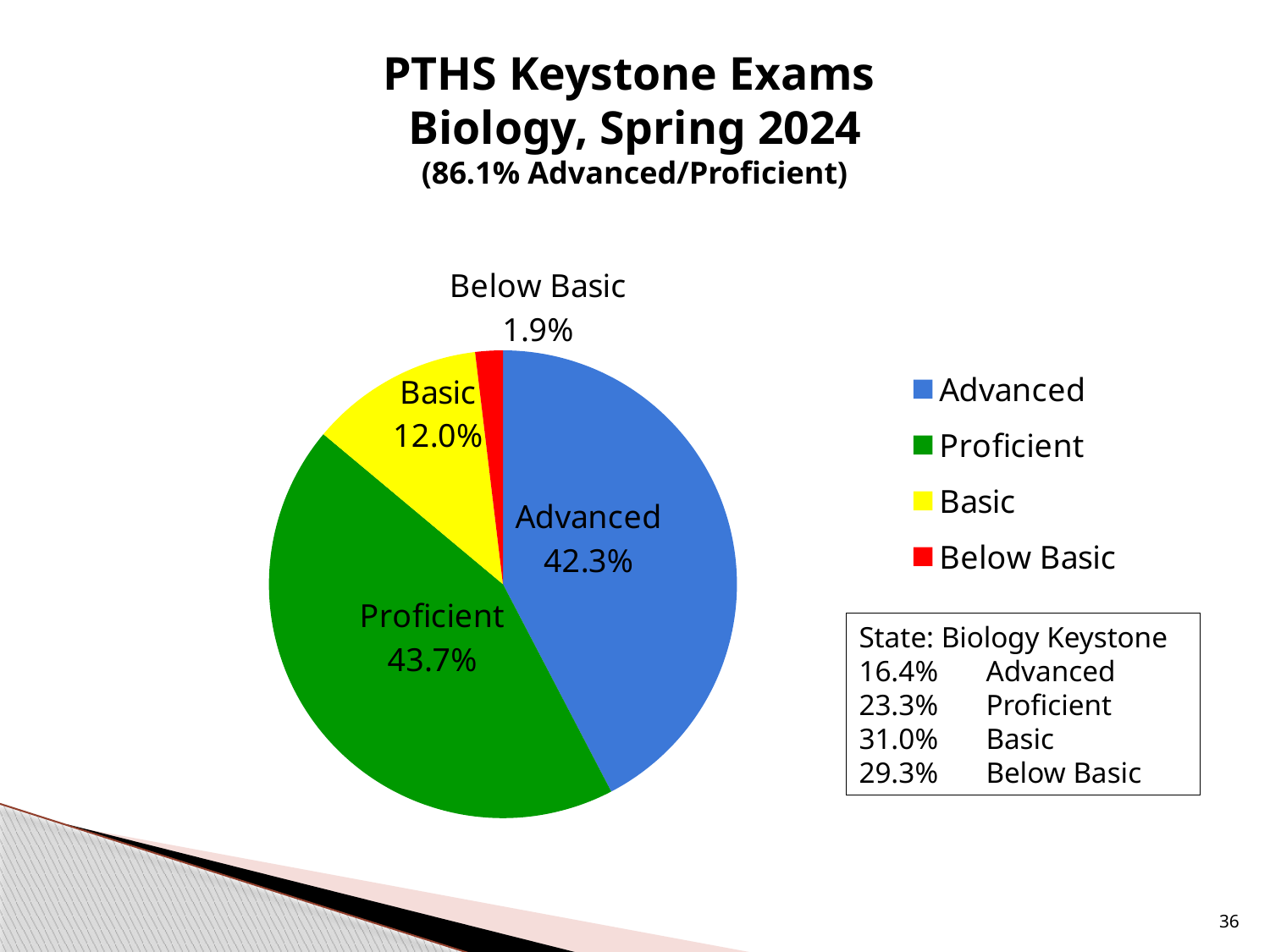
Which is larger, the Advanced share or the Basic share? Advanced What percentage of students scored Advanced on the Biology Keystone exam? 42.3% Which performance level has the smallest share of the pie? Below Basic What percentage of students scored Basic? 12.0% What colour represents the Basic slice in the pie chart? Yellow Which performance level has the largest share of the pie? Proficient What is the difference between the Basic and Below Basic percentages? 10.1% What is the difference between the Advanced and Basic percentages? 30.3% How many slices does the pie chart have? 4 What type of chart is shown on the slide? Pie chart What percentage of students scored Proficient? 43.7% What percentage of students scored Below Basic? 1.9%